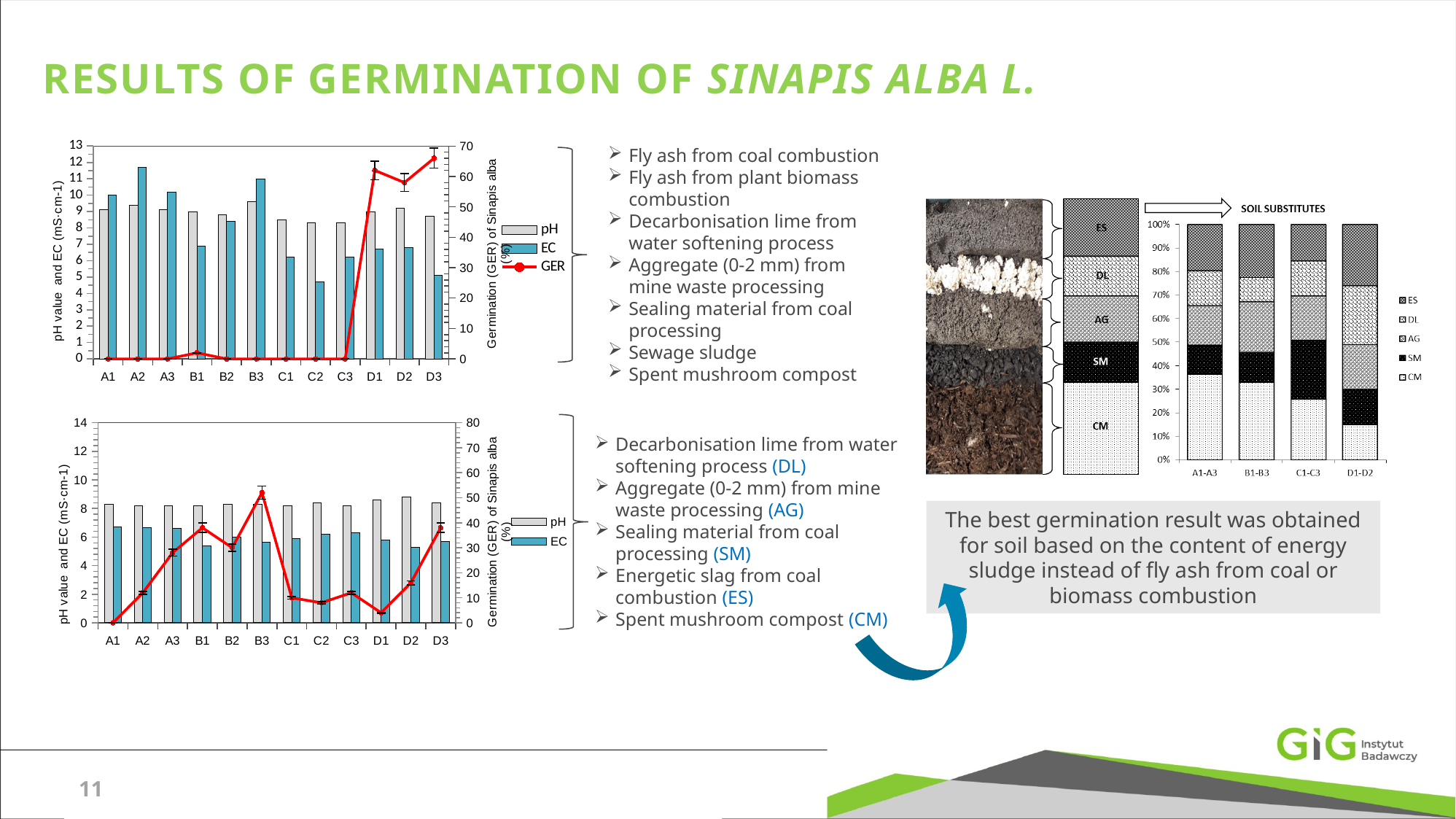
In the top-left chart, how many series does the legend list? 3 In the top-left chart, which is larger, the EC value for A2 or the EC value for C2? A2 In the bottom-left chart, is the GER value for D1 greater or less than 10? less In the SOIL SUBSTITUTES chart, what kind of chart is used? Stacked bar chart In the bottom-left chart, is the GER value for B3 greater or less than 40? greater In the top-left chart, how many soil samples are shown on the x axis? 12 In the SOIL SUBSTITUTES chart, which soil group has the smallest CM share? D1-D2 In the bottom-left chart, how many entries does the legend list? 2 In the top-left chart, is the GER value for D1 greater or less than 50? greater In the bottom-left chart, which sample has the highest GER value? B3 In the top-left chart, which sample has the highest EC value? A2